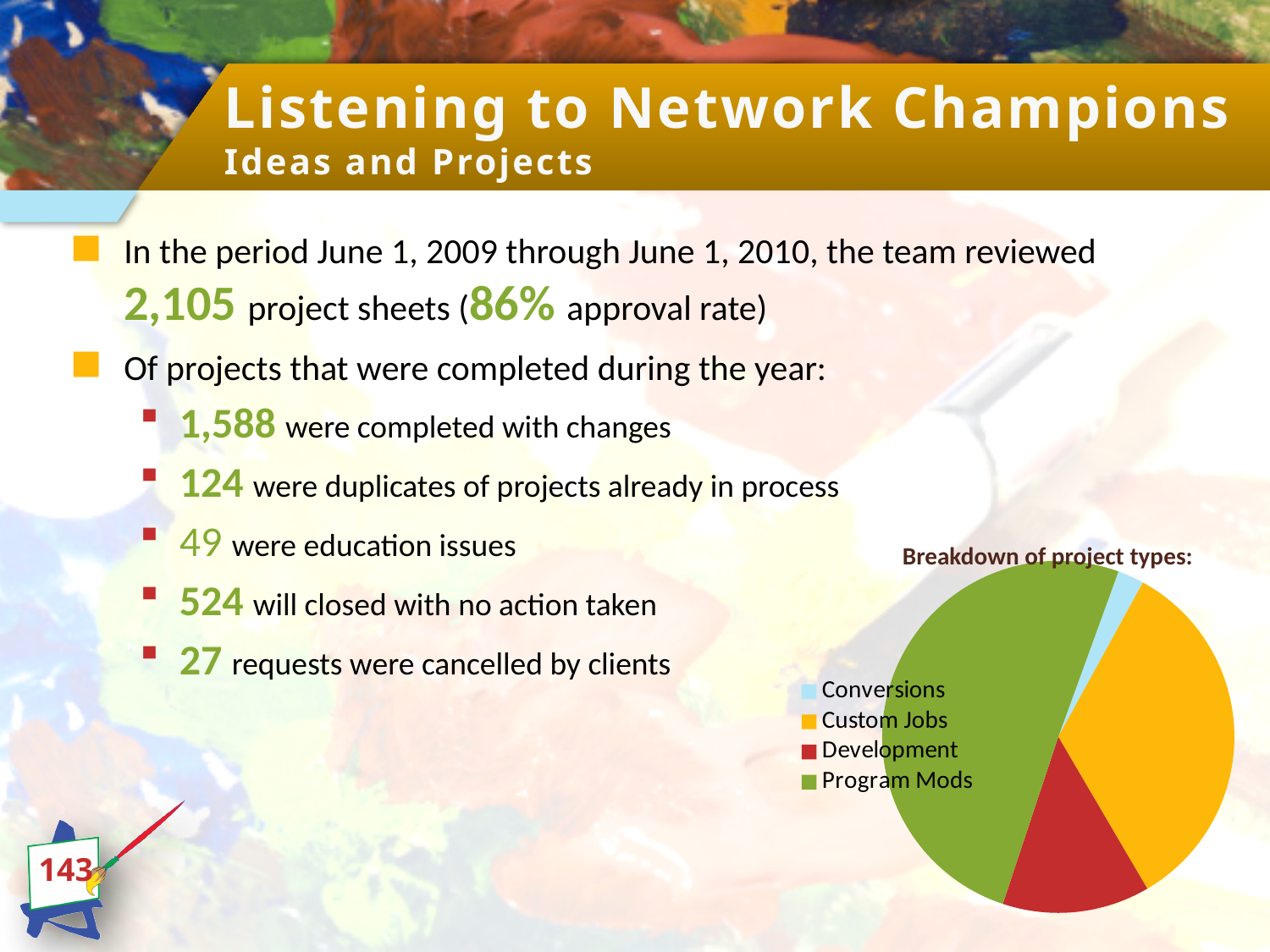
What kind of chart is shown on the slide? pie chart In the pie chart, which slice is larger: Program Mods or Development? Program Mods Which project type has the smallest slice in the pie chart? Conversions What is the title of the pie chart? Breakdown of project types: In the pie chart, which slice is larger: Custom Jobs or Development? Custom Jobs Which project type is shown in green in the pie chart? Program Mods In the pie chart, which slice is larger: Conversions or Development? Development How many entries does the legend of the pie chart list? 4 Which project type has the largest slice in the pie chart? Program Mods How many slices does the pie chart have? 4